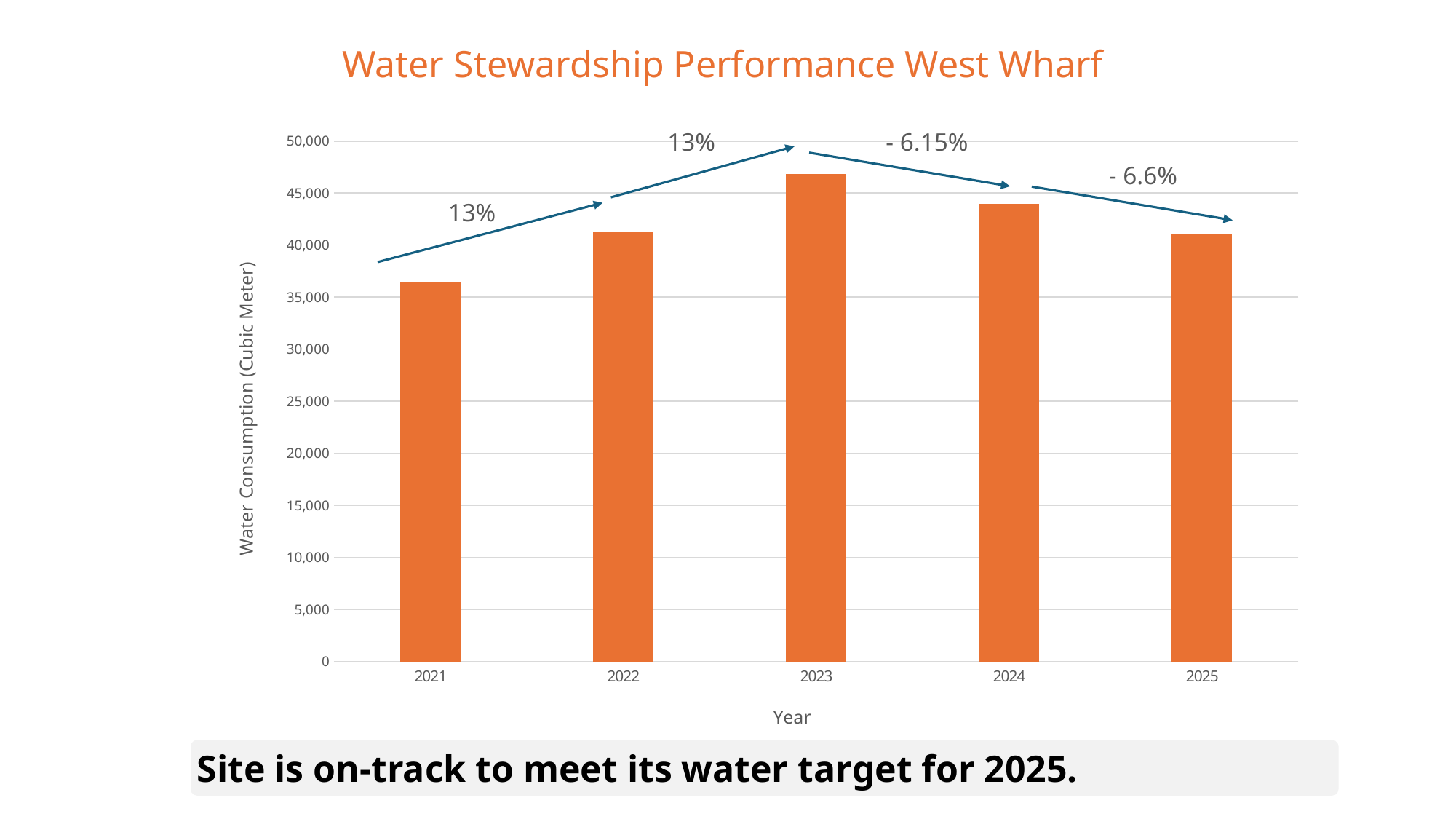
Is the water consumption for 2021 greater or less than 40,000? less What percentage change is annotated between 2024 and 2025? - 6.6% Which year has higher water consumption, 2022 or 2024? 2024 What is the title of the chart? Water Stewardship Performance West Wharf Does water consumption rise or fall from 2023 to 2025? fall Which year has the highest water consumption? 2023 What kind of chart is shown on the slide? bar chart Is the water consumption for 2024 greater or less than 45,000? less What percentage change is annotated between 2022 and 2023? 13% Which year has the lowest water consumption? 2021 How many years are plotted on the chart? 5 Is the water consumption for 2023 greater or less than 45,000? greater